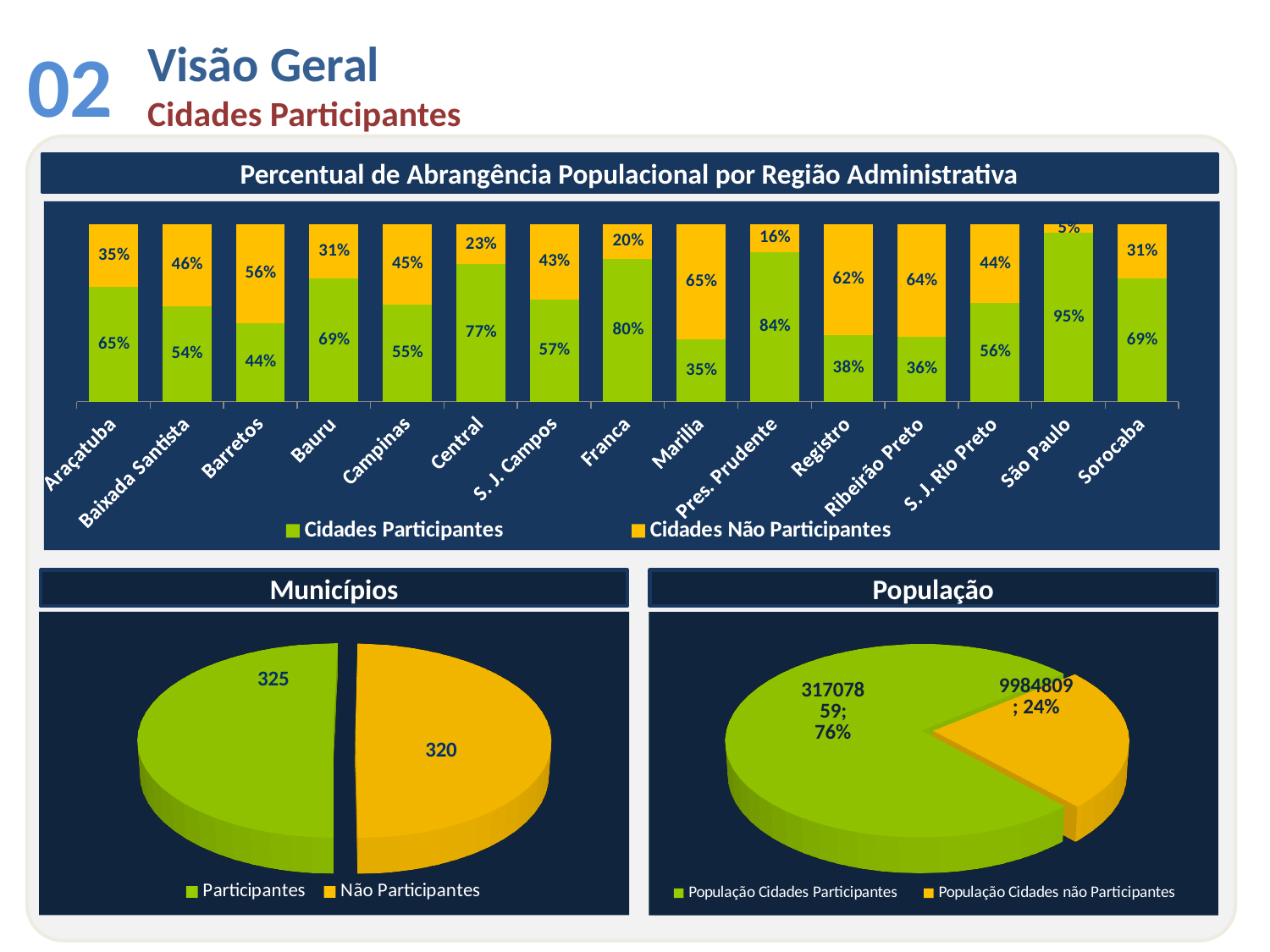
In the chart 'Percentual de Abrangência Populacional por Região Administrativa', what is the value of Cidades Não Participantes for Marília? 65% What kind of chart is 'Percentual de Abrangência Populacional por Região Administrativa'? Stacked bar chart In the chart 'Percentual de Abrangência Populacional por Região Administrativa', which is larger: the Cidades Participantes value for Central or for Campinas? Central In the chart 'Percentual de Abrangência Populacional por Região Administrativa', which region has the lowest value for Cidades Participantes? Marília In the 'Municípios' pie chart, what is the value for Participantes? 325 How many regions are shown on the x axis of the chart 'Percentual de Abrangência Populacional por Região Administrativa'? 15 In the chart 'Percentual de Abrangência Populacional por Região Administrativa', what is the difference between the Cidades Participantes values for Pres. Prudente and Registro? 46% In the 'Municípios' pie chart, what is the difference between Participantes and Não Participantes? 5 In the 'População' pie chart, what share does População Cidades não Participantes represent? 24% In the chart 'Percentual de Abrangência Populacional por Região Administrativa', what is the value of Cidades Participantes for São Paulo? 95% In the chart 'Percentual de Abrangência Populacional por Região Administrativa', which region has the highest value for Cidades Participantes? São Paulo How many series does the legend of the chart 'Percentual de Abrangência Populacional por Região Administrativa' list? 2